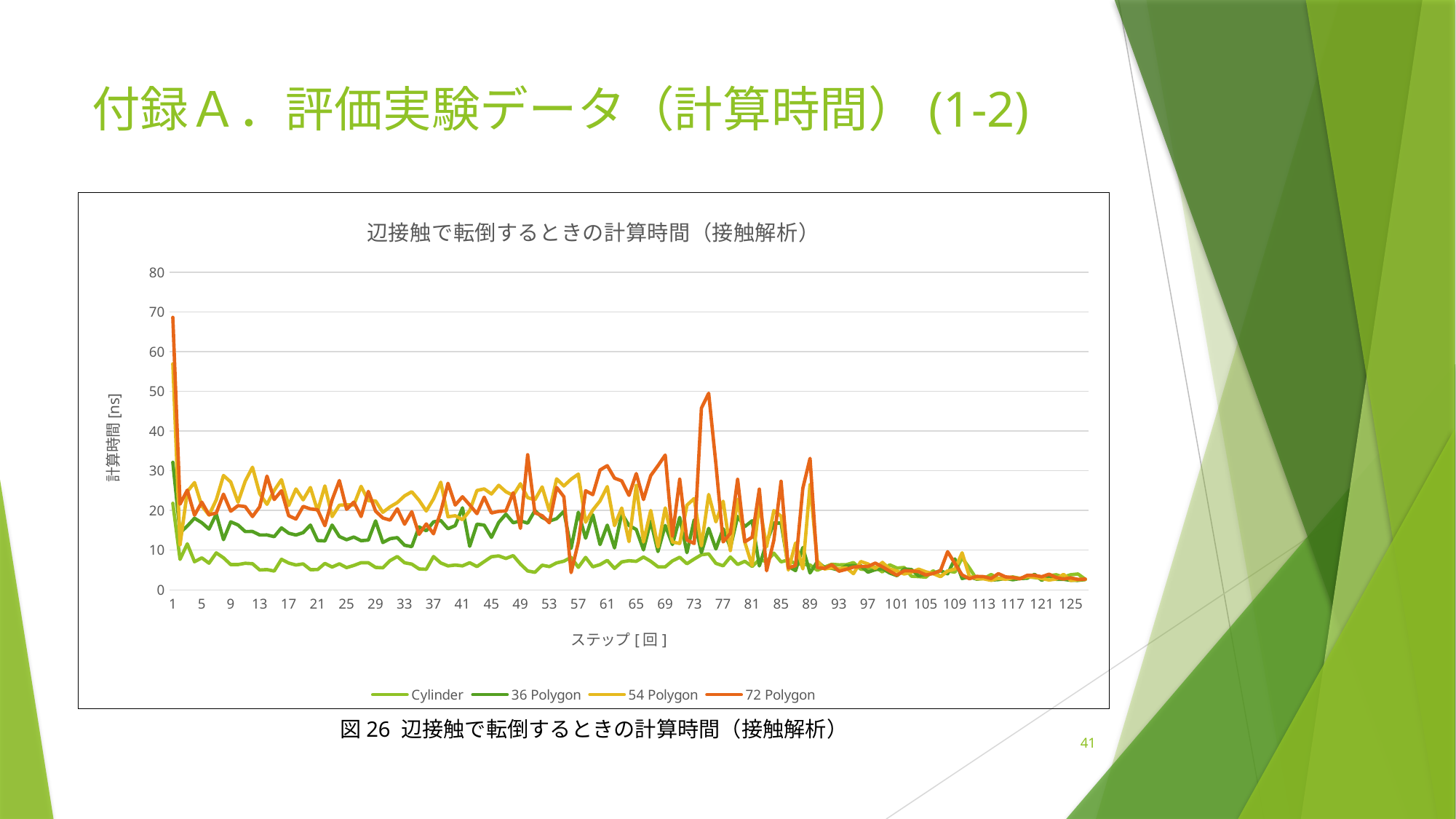
Around step 13, which is larger: the value for 54 Polygon or the value for 36 Polygon? 54 Polygon What is the title of the chart? 辺接触で転倒するときの計算時間（接触解析） Is the value for 72 Polygon at step 1 greater or less than 60? greater At step 1, which is larger: the value for 72 Polygon or the value for Cylinder? 72 Polygon What kind of chart is shown on the slide? Line chart Which series is drawn in the lightest green line according to the legend? Cylinder Do the values for 72 Polygon generally rise or fall from step 1 to step 125? fall Is the value for Cylinder at step 49 greater or less than 20? less Which series reaches the highest value anywhere on the chart? 72 Polygon Which series has the lowest values over most of the first 80 steps? Cylinder How many series does the chart legend list? 4 Is the peak value of 72 Polygon near step 75 greater or less than 40? greater